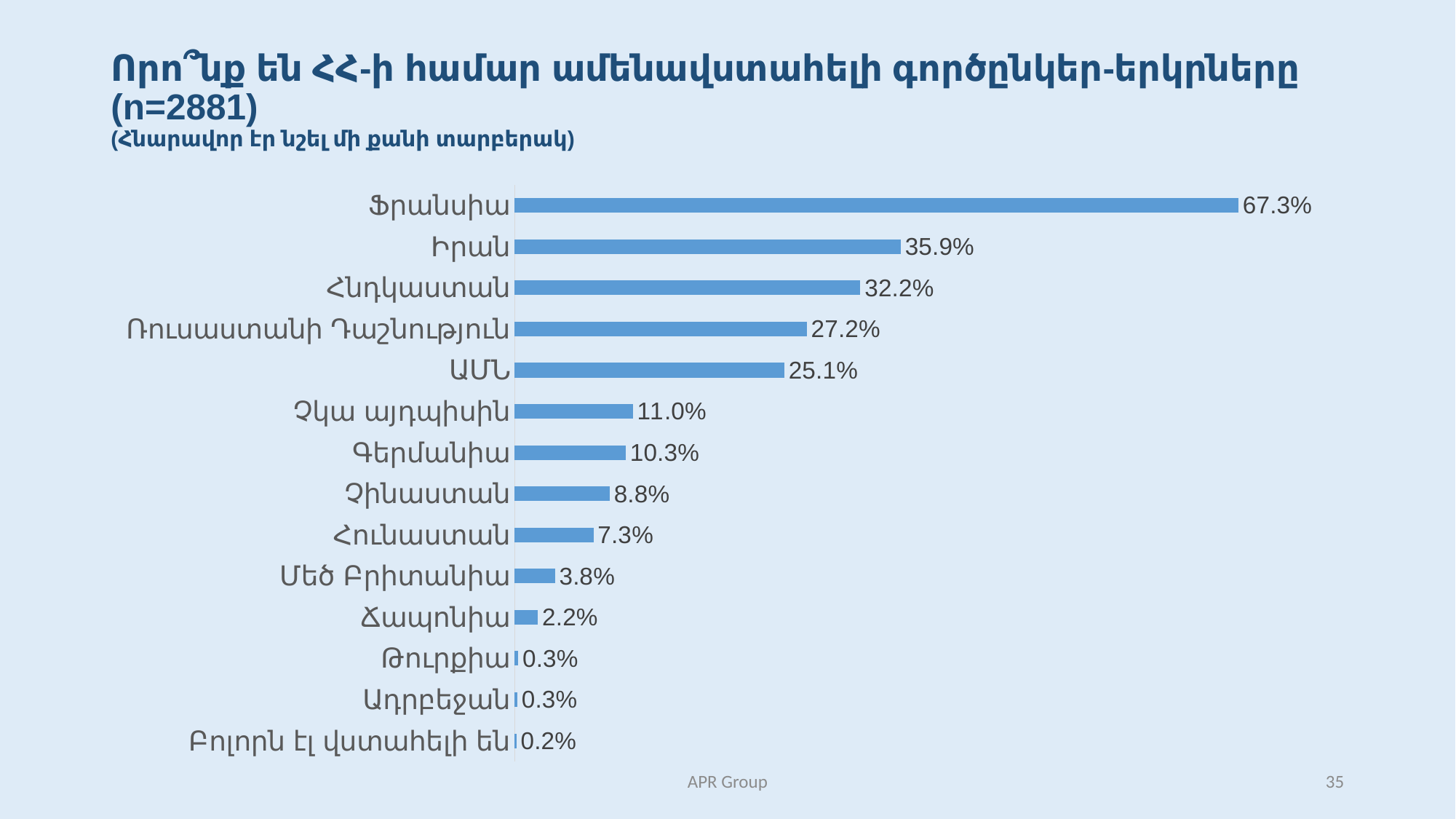
What is the difference between the values for Ֆրանսիա and ԱՄՆ? 42.2% What is the value for Ֆրանսիա? 67.3% Which is larger, the value for Չինաստան or the value for Հունաստան? Չինաստան How many categories are shown in the chart? 14 What is the value for Գերմանիա? 10.3% What sample size (n) is stated in the chart title? n=2881 What is the difference between the values for Իրան and Հնդկաստան? 3.7% What is the value for Ճապոնիա? 2.2% Which category has the highest value? Ֆրանսիա Which category has the lowest value? Բոլորն էլ վստահելի են What kind of chart is shown on the slide? bar chart What is the value for Ռուսաստանի Դաշնություն? 27.2%